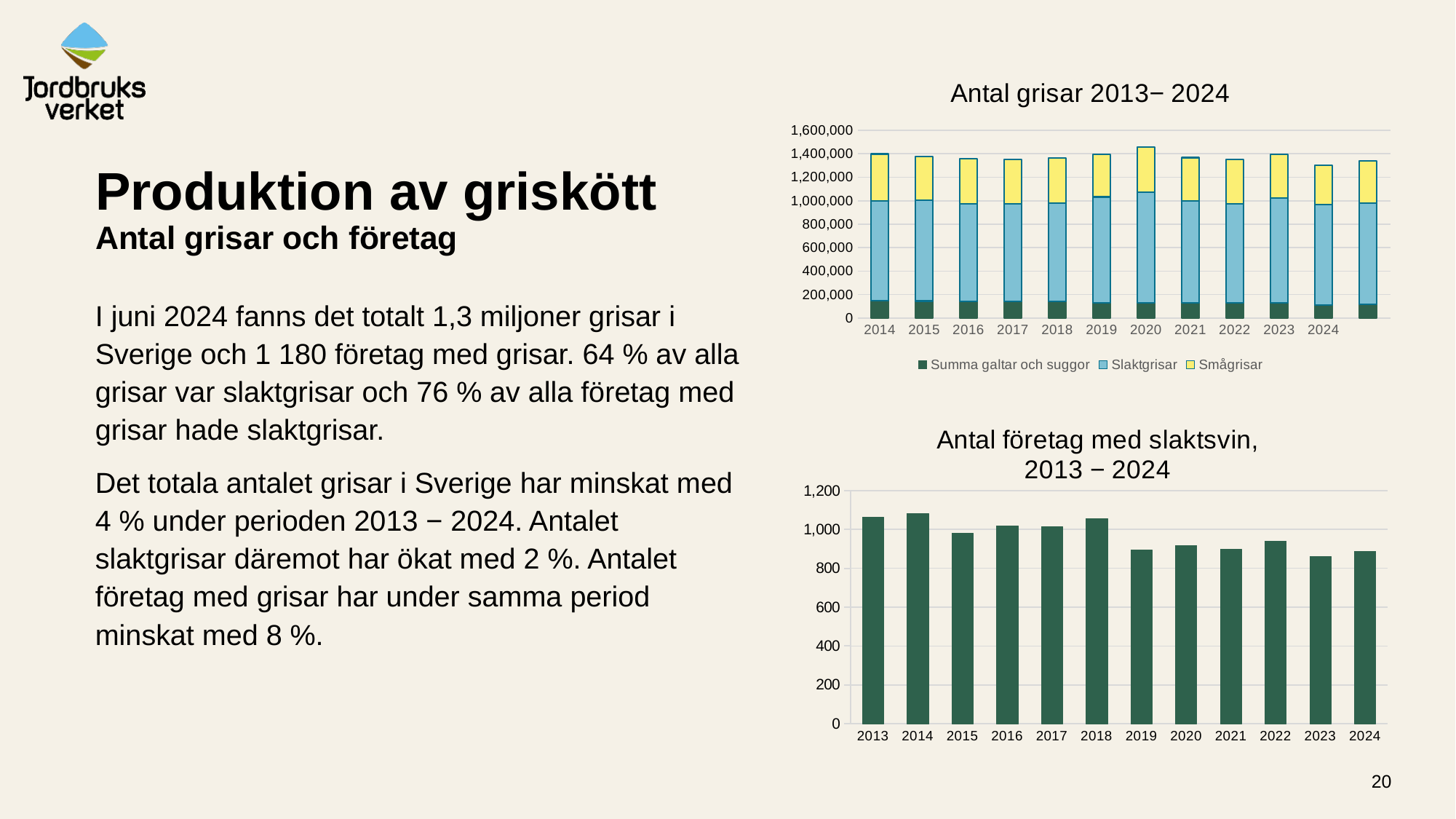
How many series does the legend of the chart "Antal grisar 2013− 2024" list? 3 In the chart "Antal företag med slaktsvin, 2013 − 2024", is the value for 2013 greater or less than 1,000? greater In the chart "Antal grisar 2013− 2024", which year has the highest total number of pigs? 2020 In the chart "Antal grisar 2013− 2024", which series is shown in yellow? Smågrisar How many years are shown on the x axis of the chart "Antal företag med slaktsvin, 2013 − 2024"? 12 In the chart "Antal grisar 2013− 2024", is the total for 2020 greater or less than 1,400,000? greater How many years are shown on the x axis of the chart "Antal grisar 2013− 2024"? 11 What kind of chart is the chart titled "Antal grisar 2013− 2024"? stacked bar chart In the chart "Antal grisar 2013− 2024", is the total for 2024 greater or less than 1,400,000? less In the chart "Antal företag med slaktsvin, 2013 − 2024", which is larger, the value for 2018 or the value for 2019? 2018 What kind of chart is the chart titled "Antal företag med slaktsvin, 2013 − 2024"? bar chart